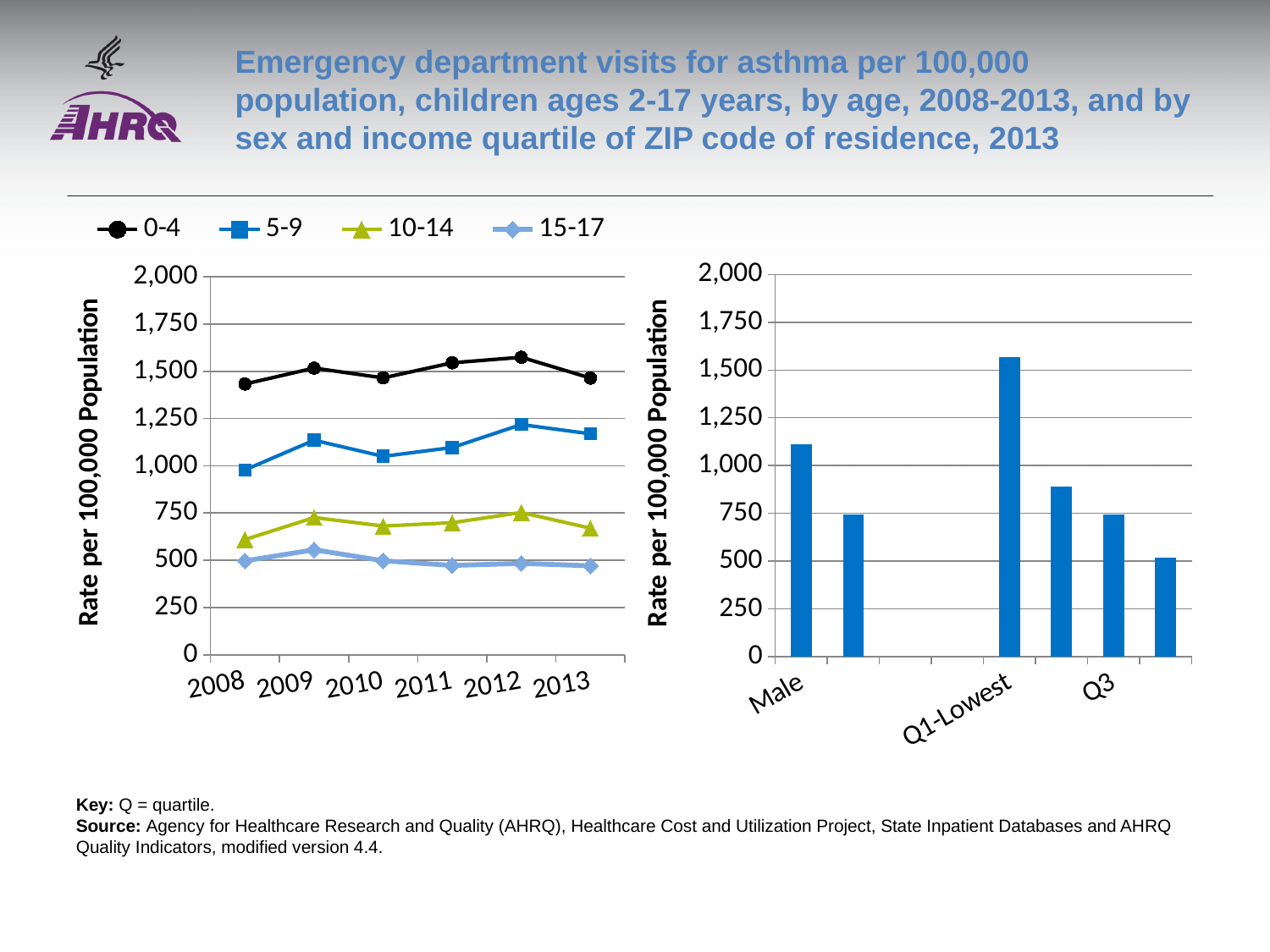
In the left chart, does the 0-4 line rise or fall from 2010 to 2012? rise What is the y-axis title of the left chart? Rate per 100,000 Population In the right chart, is the value for Q1-Lowest greater or less than 1,500? greater In the left chart, which age group has the lowest rate across all years? 15-17 In the left chart, how many age-group series does the legend list? 4 In the right chart, which is larger, the value for Male or the value for Q3? Male What kind of chart is the left chart showing rates by age group for 2008-2013? line chart In the left chart, is the value for the 0-4 age group in 2012 greater or less than 1,500? greater What kind of chart is the right chart showing rates by sex and income quartile for 2013? bar chart In the left chart, which age group has the highest rate across all years? 0-4 In the left chart, is the value for the 10-14 age group in 2008 greater or less than 750? less In the left chart, how many years are plotted along the x axis? 6